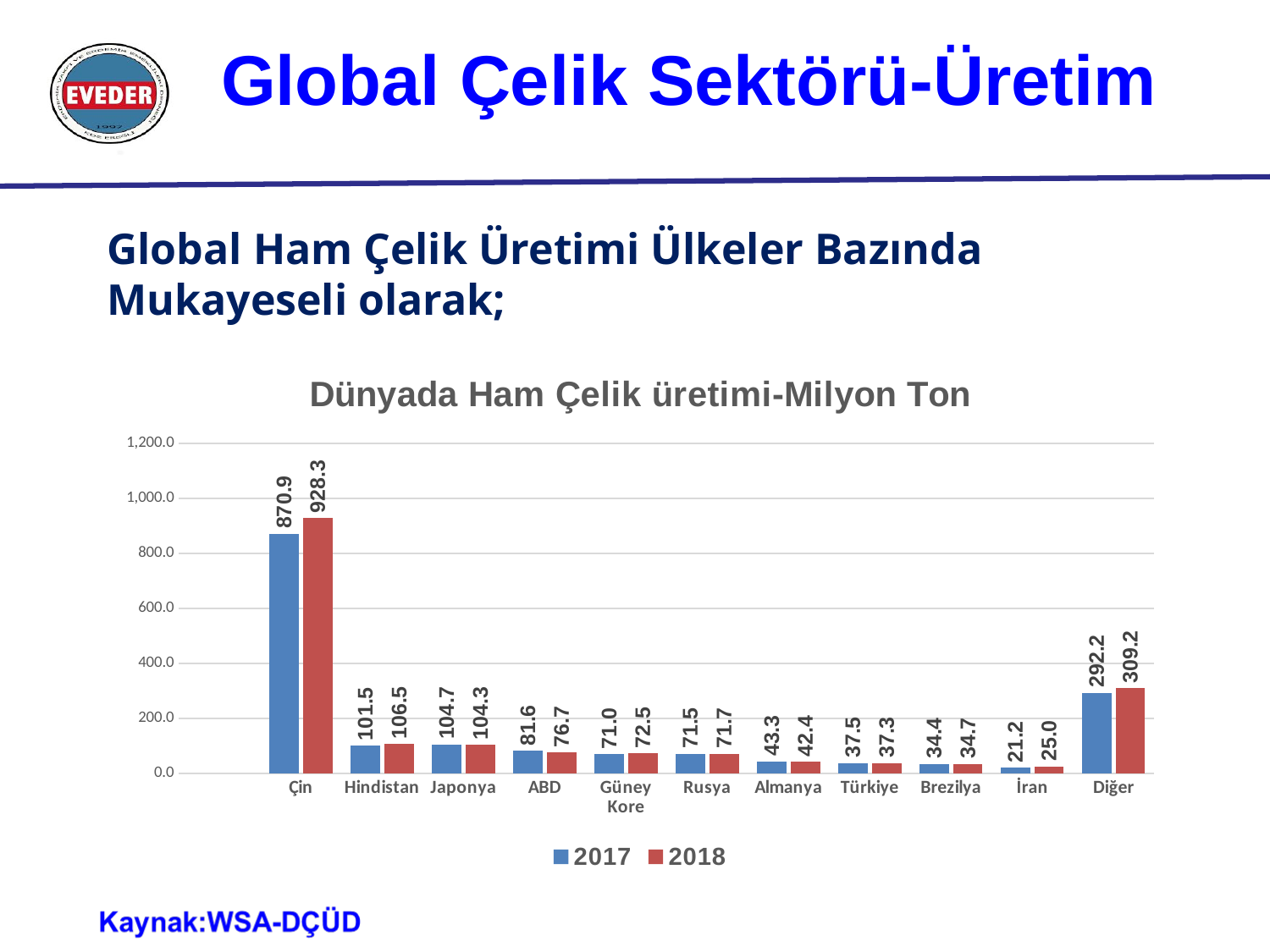
How many series does the legend list? 2 Which country has the lowest 2017 value in the chart? İran What is the 2018 value for Çin in the chart? 928.3 How many categories are shown on the x axis of the chart? 11 What is the difference between the 2018 and 2017 values for Diğer? 17.0 Which is larger for ABD: the 2017 value or the 2018 value? 2017 What is the title of the chart? Dünyada Ham Çelik üretimi-Milyon Ton What is the 2018 value for İran? 25.0 Is the 2017 value for Çin greater or less than 800.0? greater Which category has the highest 2018 value? Çin What kind of chart is shown on the slide? Bar chart What is the 2017 value for Türkiye? 37.5